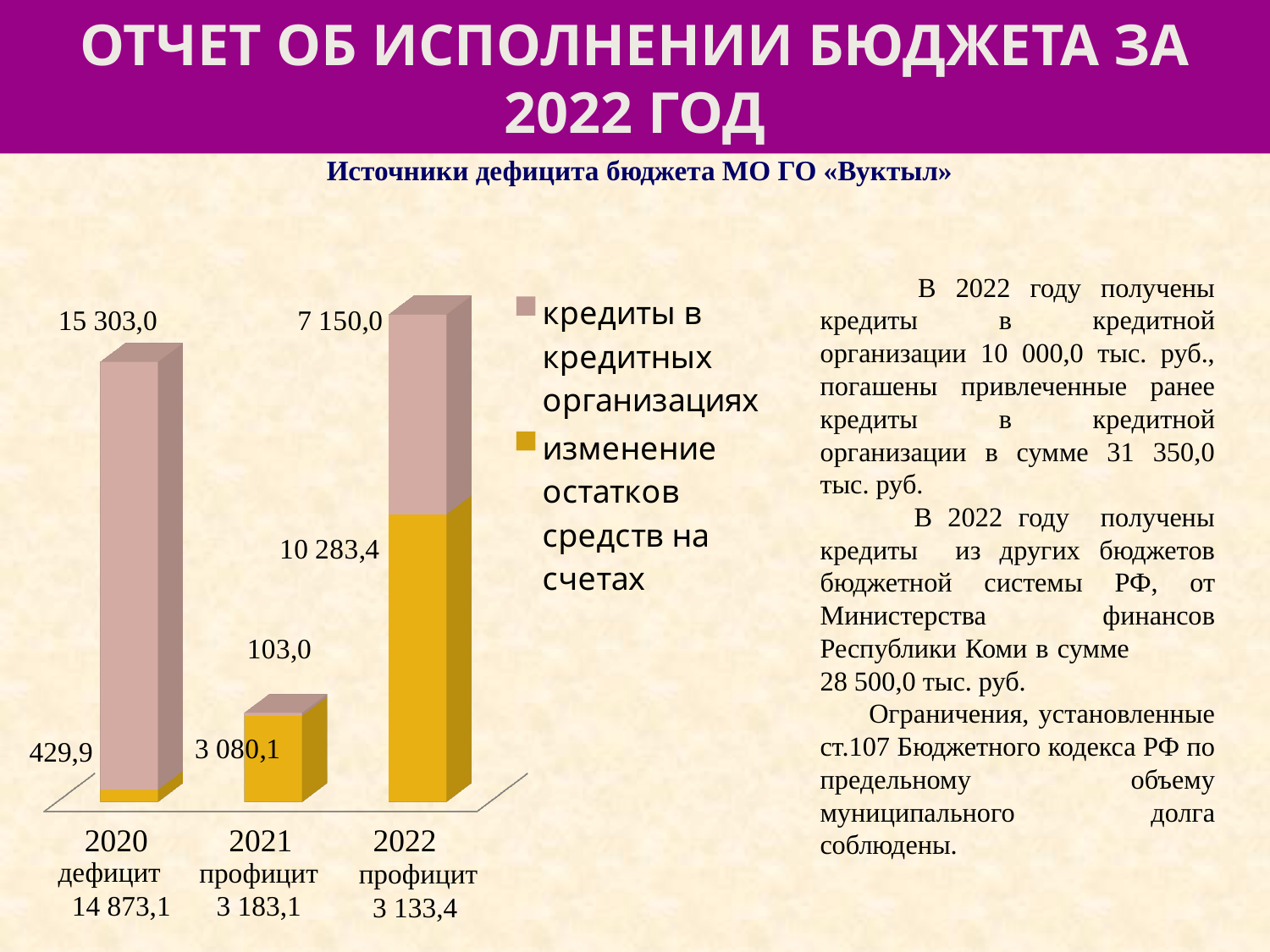
What is the total of the stacked bar for 2021? 3 183,1 What type of chart is shown on the slide? Stacked bar chart What is the value of «изменение остатков средств на счетах» for 2022? 10 283,4 What is the value of «кредиты в кредитных организациях» for 2020? 15 303,0 In which year is the value of «изменение остатков средств на счетах» the lowest? 2020 How many series does the chart legend list? 2 In which year is the value of «кредиты в кредитных организациях» the highest? 2020 Which is larger in 2022: «кредиты в кредитных организациях» or «изменение остатков средств на счетах»? изменение остатков средств на счетах What is the difference between the «кредиты в кредитных организациях» values for 2020 and 2022? 8 153,0 What is the title of the chart on the slide? Источники дефицита бюджета МО ГО «Вуктыл» How many years (categories) are shown on the x axis of the chart? 3 What is the value of «кредиты в кредитных организациях» for 2021? 103,0